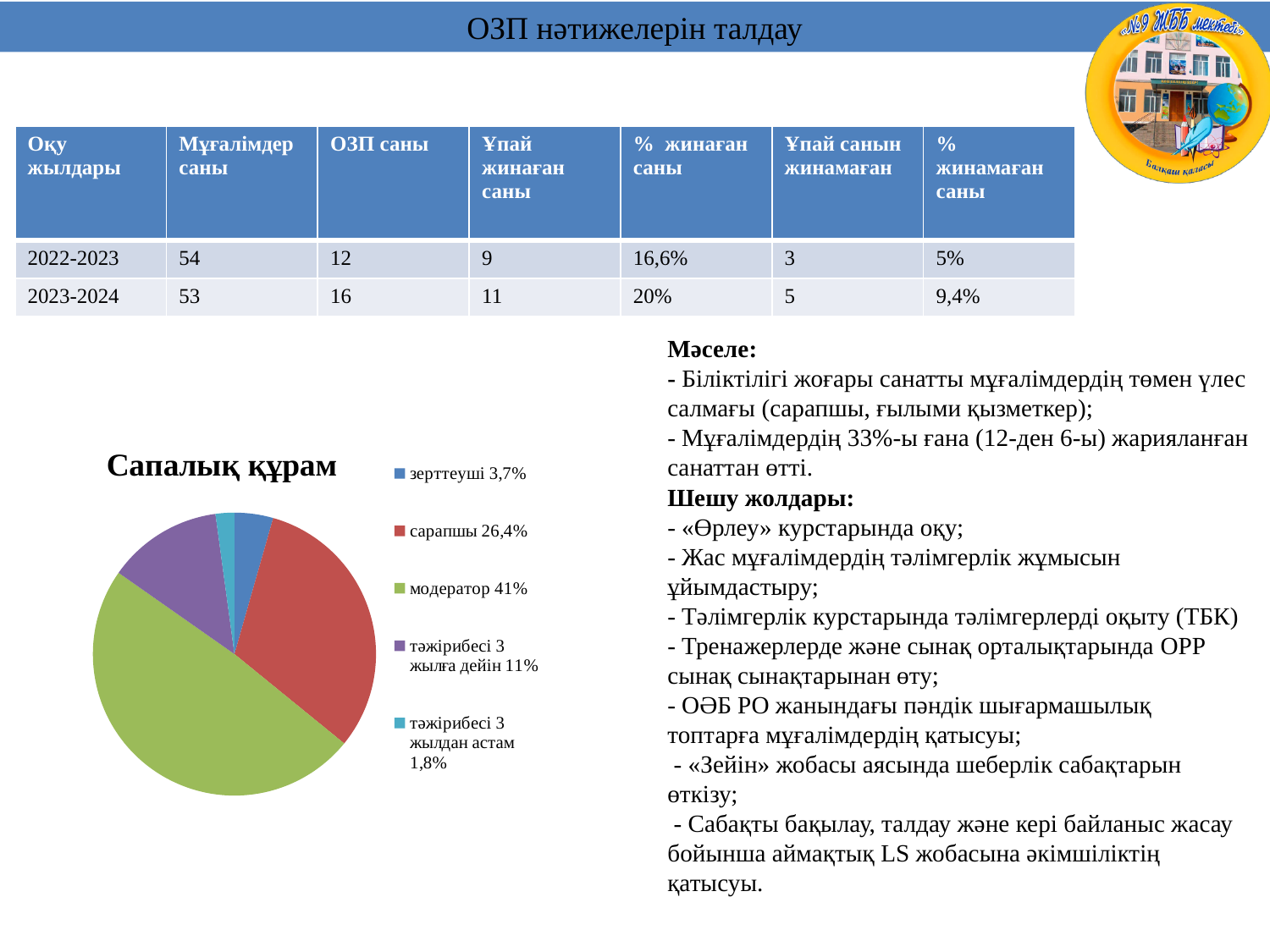
What kind of chart is shown under the title "Сапалық құрам"? pie chart How many slices does the "Сапалық құрам" pie chart have? 5 Which category has the largest slice in the "Сапалық құрам" pie chart? модератор What is the title of the pie chart on the slide? Сапалық құрам In the "Сапалық құрам" pie chart, what share is shown for "зерттеуші"? 3,7% In the "Сапалық құрам" pie chart, what share is shown for "модератор"? 41% Which category has the smallest slice in the "Сапалық құрам" pie chart? тәжірибесі 3 жылдан астам In the "Сапалық құрам" pie chart, what colour is the "модератор" slice? green In the "Сапалық құрам" pie chart, what share is shown for "тәжірибесі 3 жылдан астам"? 1,8% In the "Сапалық құрам" pie chart, which is larger: the share for "сарапшы" or the share for "тәжірибесі 3 жылға дейін"? сарапшы In the "Сапалық құрам" pie chart, what share is shown for "тәжірибесі 3 жылға дейін"? 11% In the "Сапалық құрам" pie chart, what share is shown for "сарапшы"? 26,4%